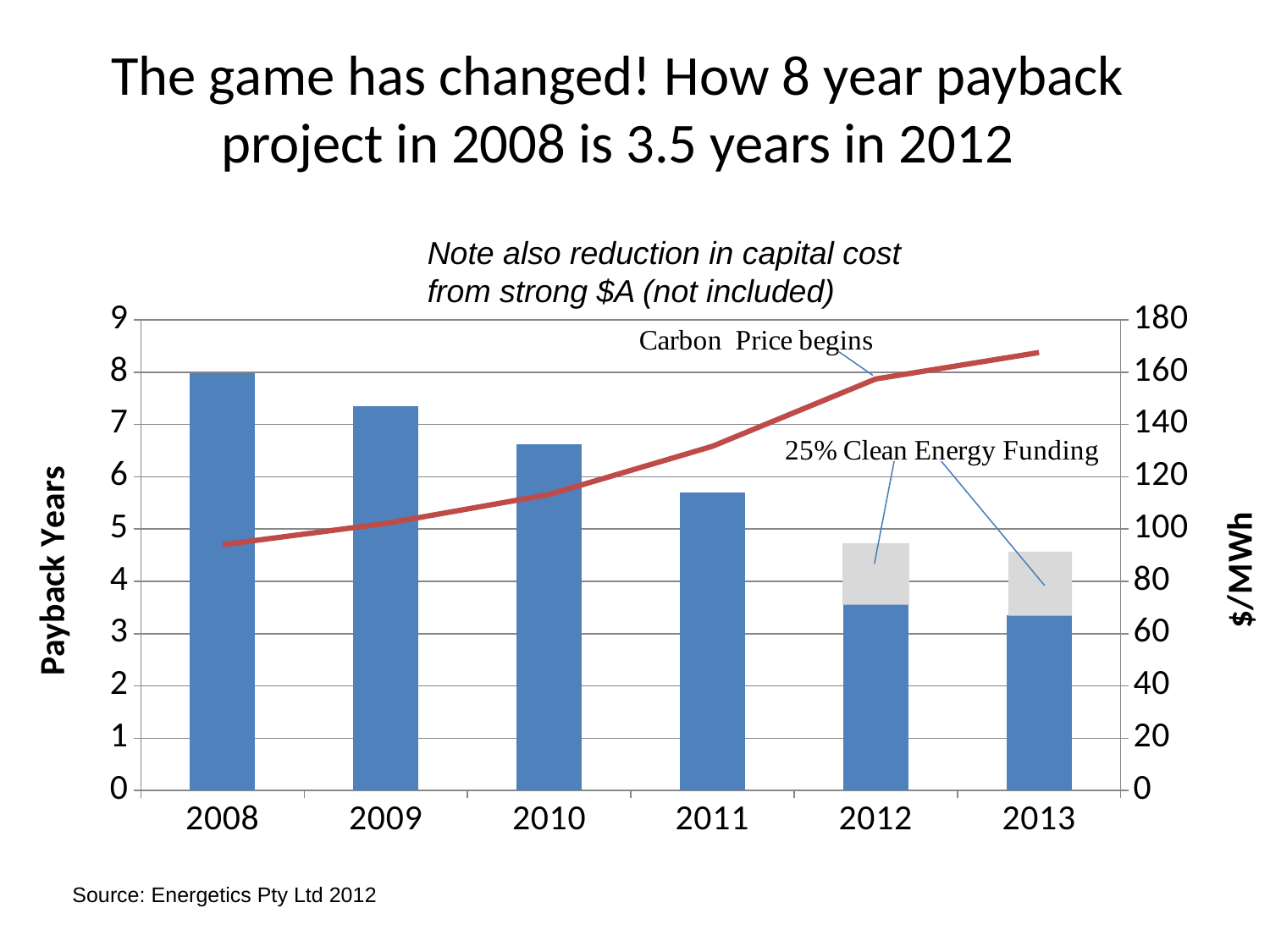
Is the $/MWh line value for 2008 greater or less than 100? less How many years are shown on the x axis? 6 What is the label of the right-hand vertical axis? $/MWh Which year has the lowest blue payback bar? 2013 Do the payback bars rise or fall from 2008 to 2013? fall Is the $/MWh line value for 2013 greater or less than 160? greater According to the slide title, what is the payback in years for the project in 2012? 3.5 years Does the red $/MWh line rise or fall from 2008 to 2013? rise What is the payback in years shown for 2008? 8 Which year has the tallest payback bar? 2008 Is the payback bar for 2009 greater or less than 7 years? greater